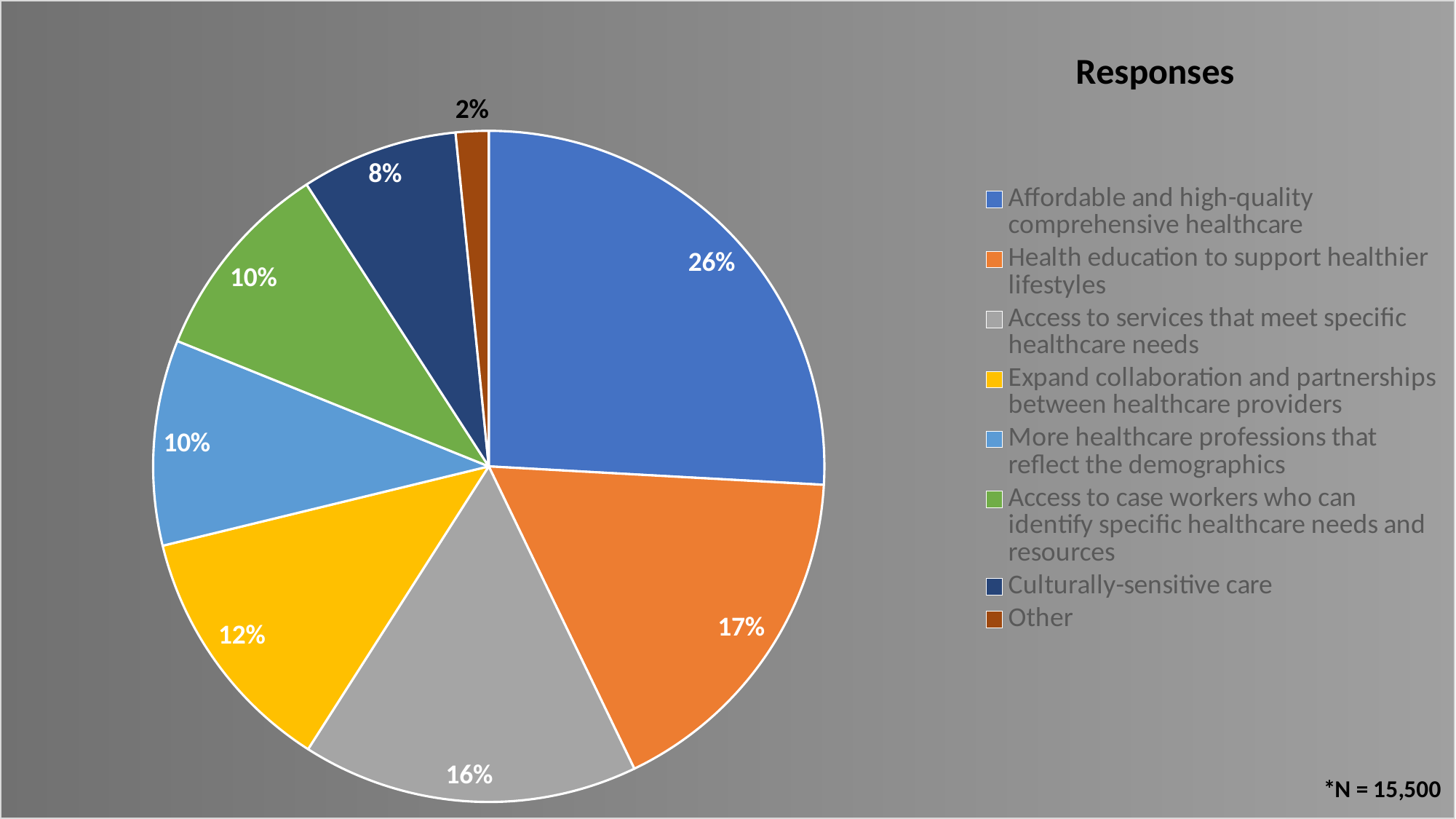
What is the difference in percentage points between 'Affordable and high-quality comprehensive healthcare' and 'Health education to support healthier lifestyles'? 9 percentage points What is the title of the chart? Responses Which category has the largest share of responses? Affordable and high-quality comprehensive healthcare Which category has the smallest share of responses? Other What kind of chart is shown on the slide? pie chart Which is larger: the share for 'Expand collaboration and partnerships between healthcare providers' or the share for 'Culturally-sensitive care'? Expand collaboration and partnerships between healthcare providers What share of responses is for 'Health education to support healthier lifestyles'? 17% What share of responses is for 'Expand collaboration and partnerships between healthcare providers'? 12% What share of responses is for 'Culturally-sensitive care'? 8% How many categories does the legend list? 8 What share of responses is for 'Affordable and high-quality comprehensive healthcare'? 26% What share of responses is for 'Access to services that meet specific healthcare needs'? 16%